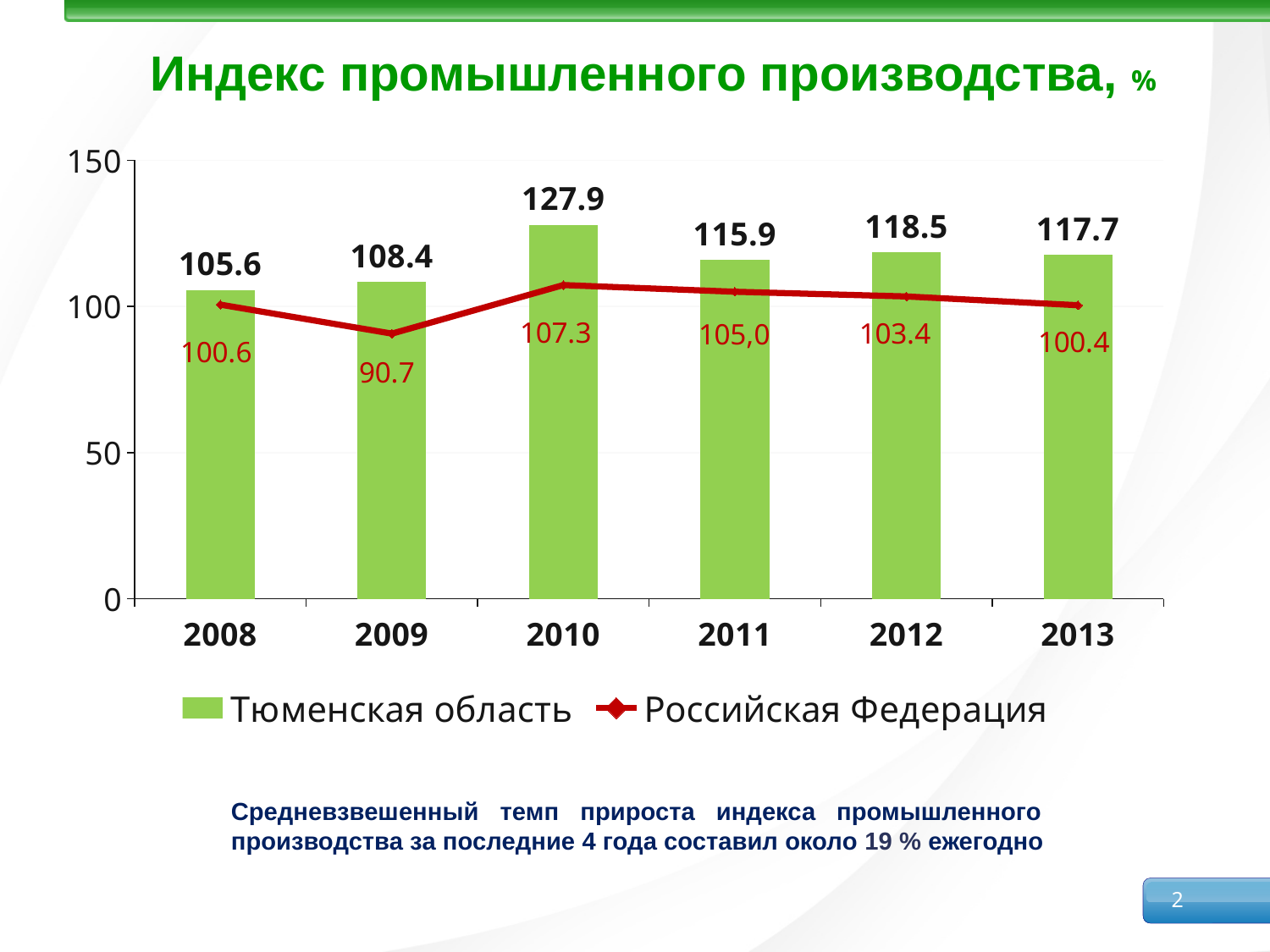
In which year is the value for Российская Федерация lowest? 2009 How many series does the legend list? 2 What is the difference between the Тюменская область and Российская Федерация values in 2010? 20.6 What is the value for Российская Федерация in 2009? 90.7 Does the value for Российская Федерация rise or fall from 2010 to 2013? fall How many years are shown on the x axis? 6 In which year is the value for Тюменская область highest? 2010 In which year is the value for Тюменская область lowest? 2008 What is the value for Российская Федерация in 2011? 105,0 What is the difference between the Тюменская область values for 2010 and 2009? 19.5 What is the value for Тюменская область in 2010? 127.9 Which is larger in 2012: the value for Тюменская область or for Российская Федерация? Тюменская область